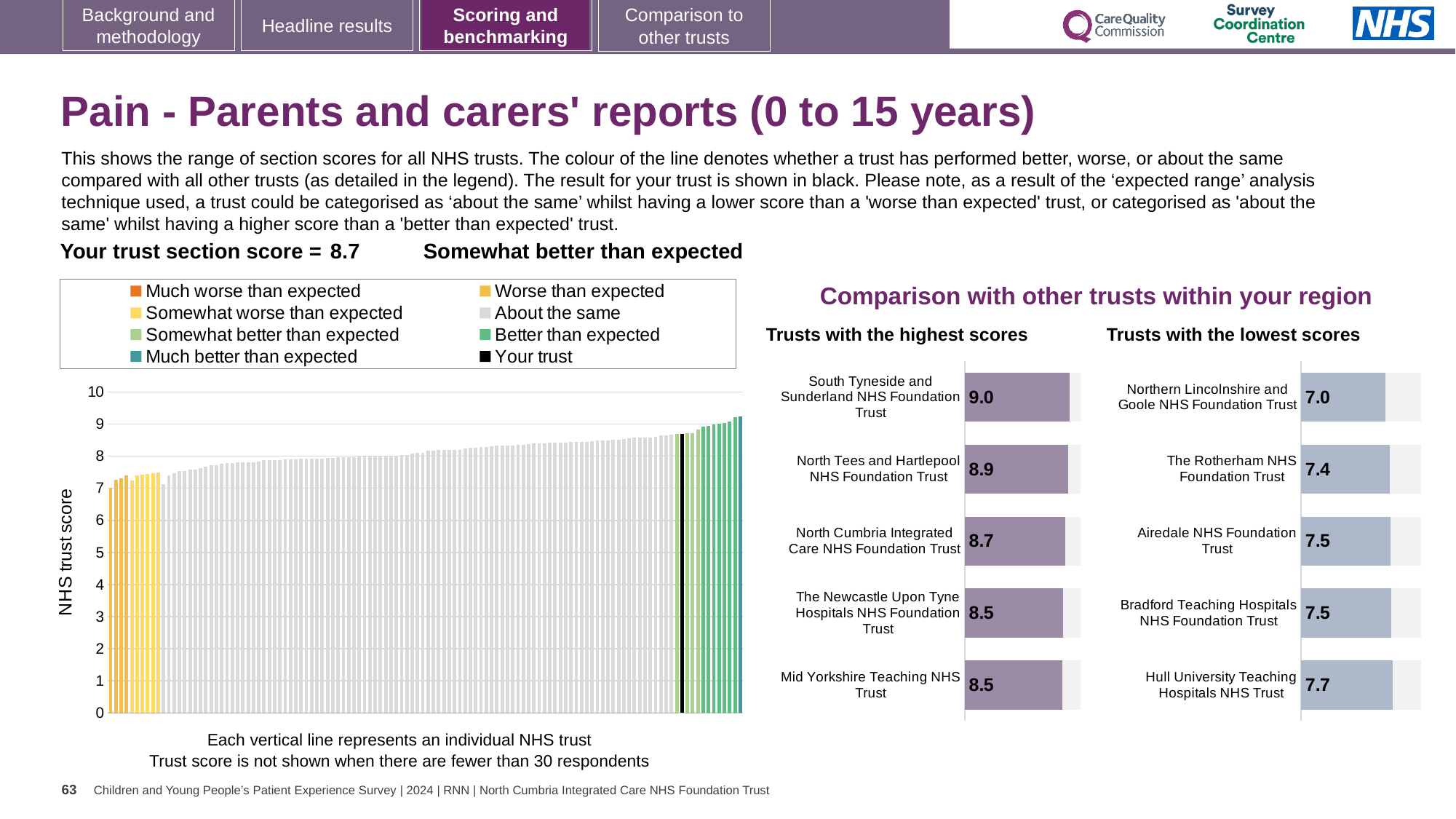
In the 'Trusts with the highest scores' chart, what is the difference between the scores of South Tyneside and Sunderland NHS Foundation Trust and Mid Yorkshire Teaching NHS Trust? 0.5 In the NHS trust score chart on the left, do the bar values rise or fall from left to right? rise In the 'Trusts with the lowest scores' chart, what is the score for Northern Lincolnshire and Goole NHS Foundation Trust? 7.0 What is the section score for your trust shown on the slide? 8.7 In the NHS trust score chart on the left, is the value of the black 'Your trust' bar greater or less than 8? greater How many trusts are shown in the 'Trusts with the highest scores' chart? 5 In the 'Trusts with the lowest scores' chart, which trust has the lowest score? Northern Lincolnshire and Goole NHS Foundation Trust In the 'Trusts with the lowest scores' chart, which has the larger score: The Rotherham NHS Foundation Trust or Hull University Teaching Hospitals NHS Trust? Hull University Teaching Hospitals NHS Trust In the 'Trusts with the highest scores' chart, which trust has the highest score? South Tyneside and Sunderland NHS Foundation Trust In the 'Trusts with the highest scores' chart, what is the score for South Tyneside and Sunderland NHS Foundation Trust? 9.0 What kind of chart is the NHS trust score chart on the left of the slide? bar chart How many entries does the legend of the NHS trust score bar chart on the left list? 8